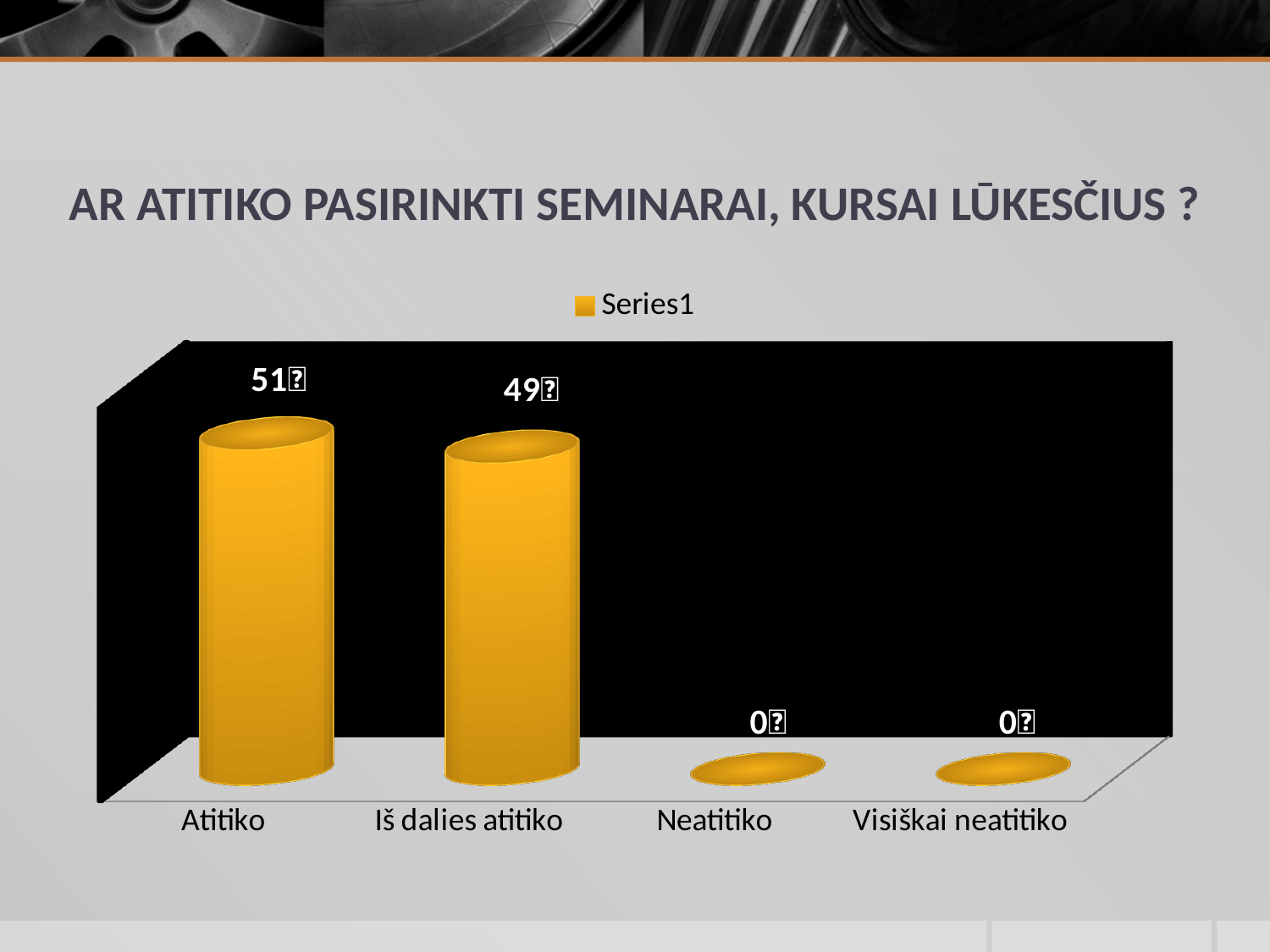
What is the title of the slide? AR ATITIKO PASIRINKTI SEMINARAI, KURSAI LŪKESČIUS ? What is the value shown for Visiškai neatitiko? 0 What is the value shown for Neatitiko? 0 How many series does the legend list? 1 Which category has the highest value? Atitiko What is the difference between the values for Atitiko and Iš dalies atitiko? 2 What kind of chart is shown on the slide? Bar chart What is the value shown for Iš dalies atitiko? 49 What is the name of the series shown in the legend? Series1 What is the value shown for Atitiko? 51 How many categories are shown on the x axis? 4 Which is larger, the value for Atitiko or the value for Neatitiko? Atitiko